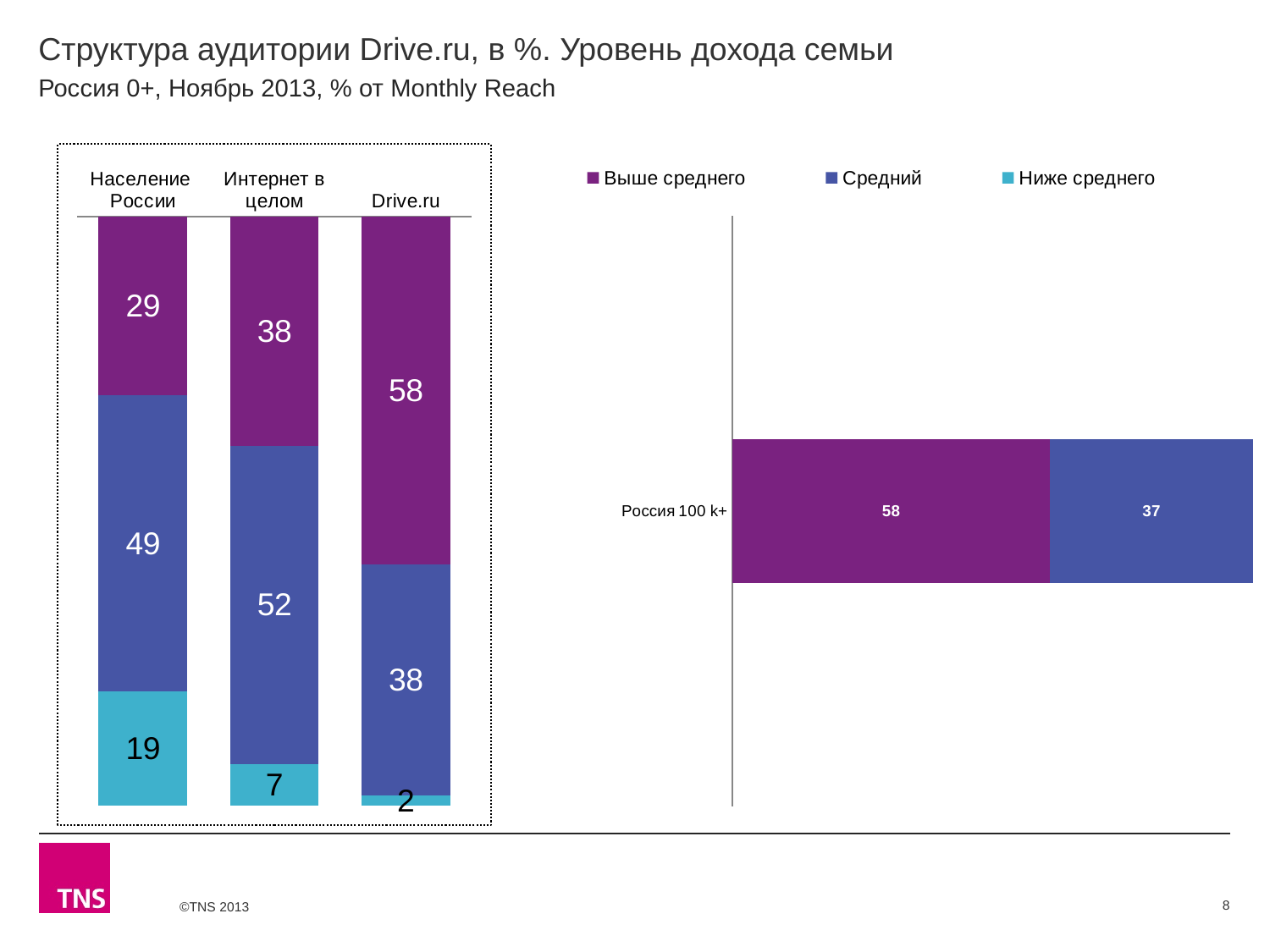
In the left stacked bar chart, what is the total of the stacked bar for Интернет в целом? 97 In the left stacked bar chart, which category has the lowest 'Ниже среднего' value? Drive.ru In the left stacked bar chart, which category has the highest 'Выше среднего' value? Drive.ru What type of chart is the right chart labelled 'Россия 100 k+'? Stacked bar chart In the left stacked bar chart, what is the value of the 'Средний' segment for Интернет в целом? 52 How many series does the legend list? 3 In the left stacked bar chart, which is larger: the 'Средний' value for Население России or for Интернет в целом? Интернет в целом In the left stacked bar chart, what is the value of the 'Ниже среднего' segment for Население России? 19 In the right chart, what is the 'Средний' value for Россия 100 k+? 37 In the left stacked bar chart, what is the difference between the 'Выше среднего' values for Drive.ru and Население России? 29 In the left stacked bar chart, what is the value of the 'Выше среднего' segment for Drive.ru? 58 How many categories are shown in the left stacked bar chart? 3